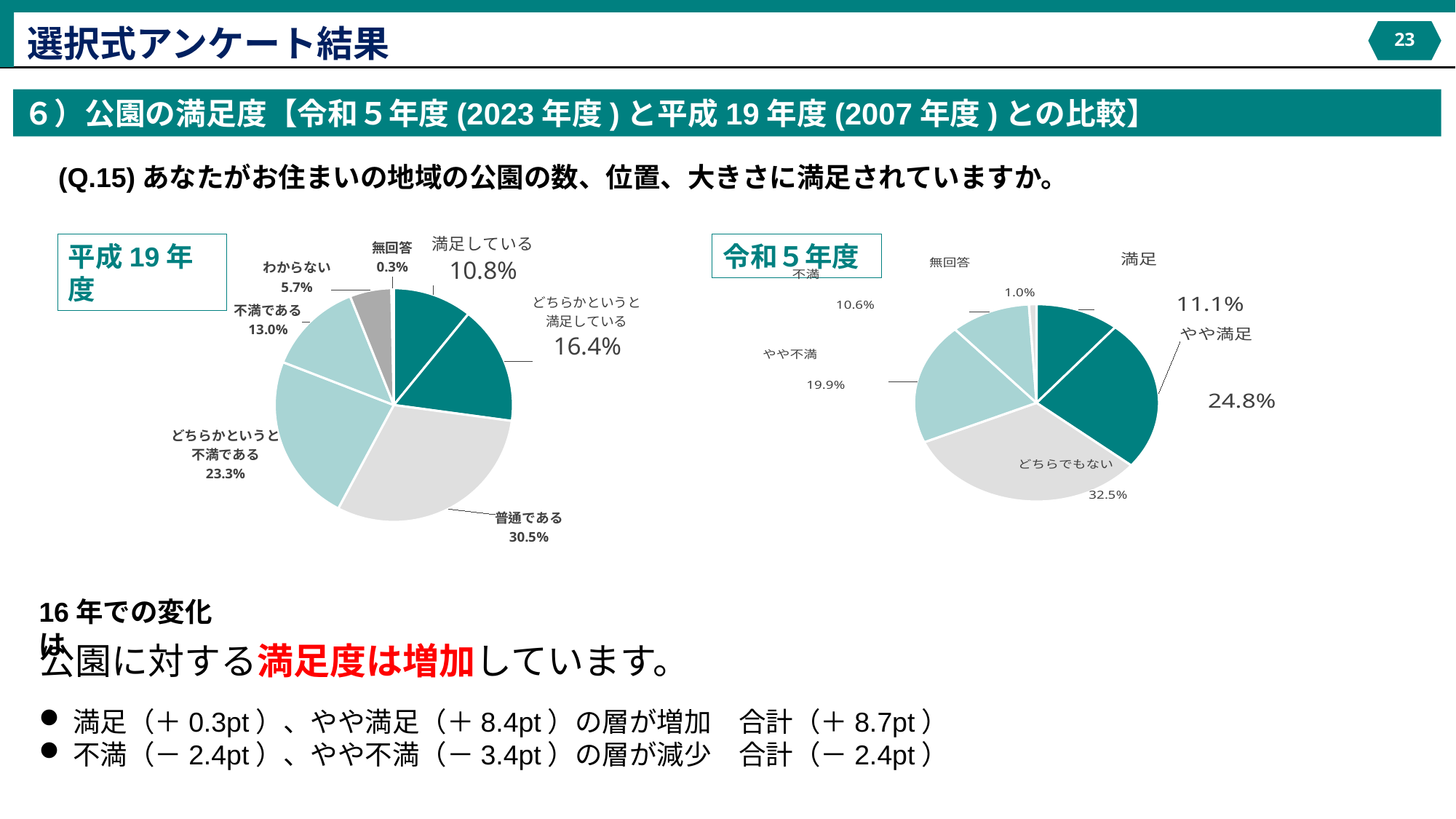
In the 平成19年度 pie chart, which is larger: どちらかというと不満である or 不満である? どちらかというと不満である In the 平成19年度 pie chart, what percentage is shown for 普通である? 30.5% In the 令和5年度 pie chart, what is the difference between やや不満 and 不満? 9.3% In the 平成19年度 pie chart, what percentage is shown for 無回答? 0.3% In the 令和5年度 pie chart, what percentage is shown for 無回答? 1.0% How many categories does the 令和5年度 pie chart show? 6 In the 令和5年度 pie chart, what percentage is shown for やや満足? 24.8% In the 平成19年度 pie chart, which category has the smallest share? 無回答 What type of chart is used for the 令和5年度 data? Pie chart How many categories does the 平成19年度 pie chart show? 7 In the 令和5年度 pie chart, which category has the largest share? どちらでもない In the 平成19年度 pie chart, what is the combined share of 満足している and どちらかというと満足している? 27.2%